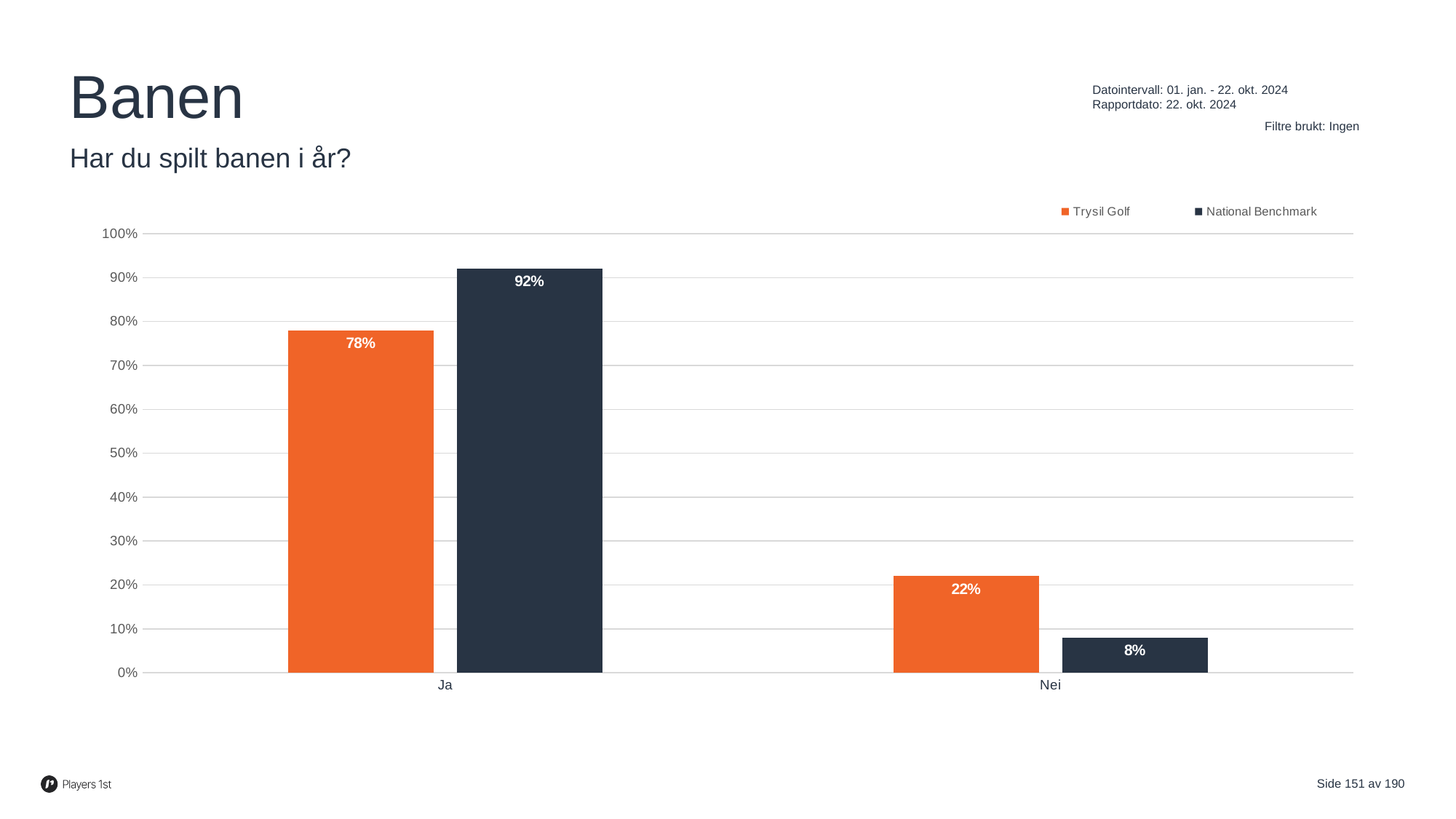
What is the value for Trysil Golf in the Nei category? 22% Which colour represents Trysil Golf in the chart? Orange What is the difference between National Benchmark and Trysil Golf in the Ja category? 14% How many categories are shown on the x axis? 2 How many series does the legend list? 2 Which is larger in the Nei category, Trysil Golf or National Benchmark? Trysil Golf What is the value for National Benchmark in the Ja category? 92% Which category has the lowest value for Trysil Golf? Nei What kind of chart is shown on the slide? Bar chart What is the value for National Benchmark in the Nei category? 8% Which category has the highest value for National Benchmark? Ja What is the value for Trysil Golf in the Ja category? 78%